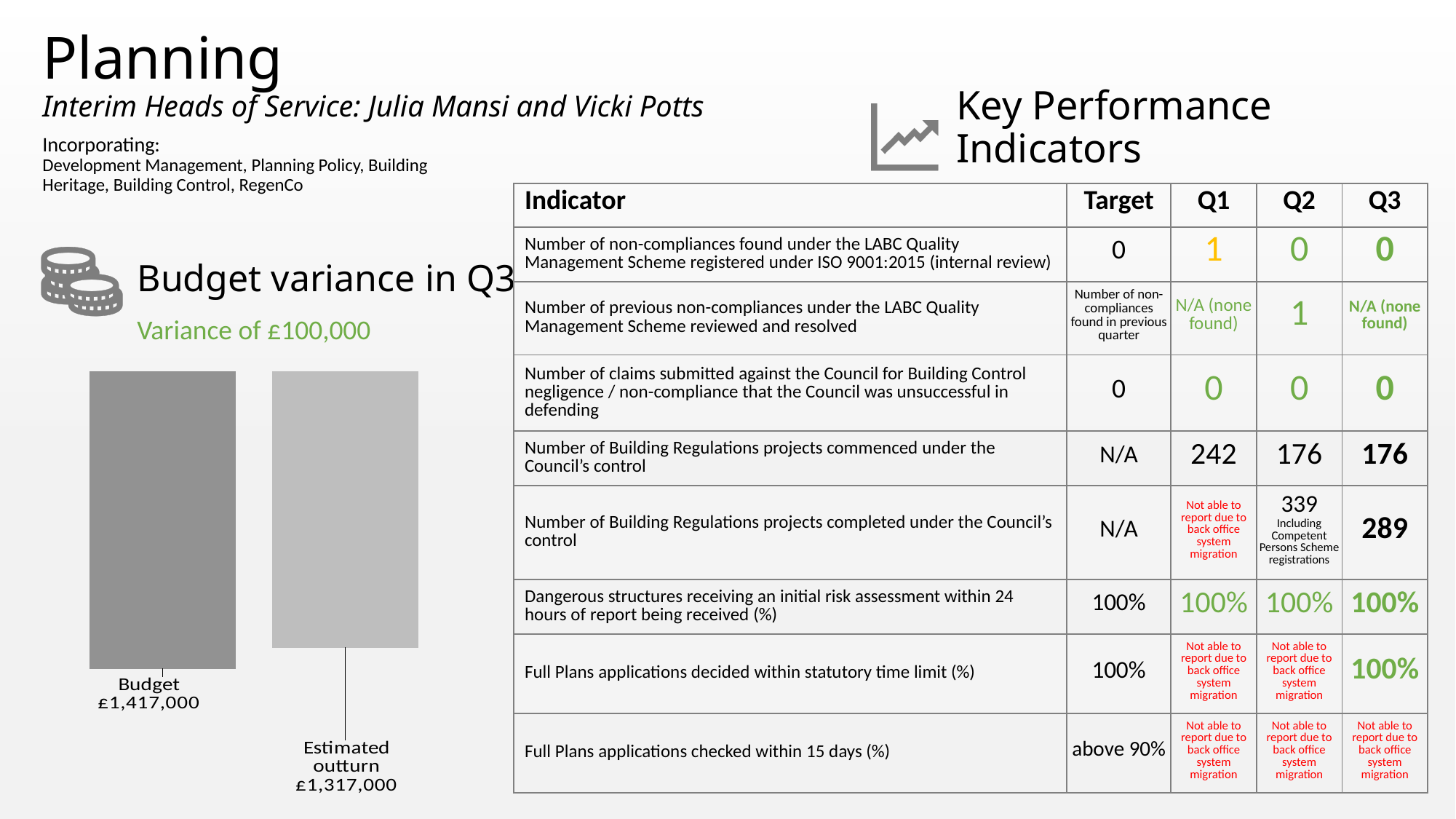
What is the difference between the Budget and Estimated outturn values in the budget variance chart? £100,000 What type of chart is shown under the 'Budget variance in Q3' heading? bar chart What is the heading above the bar chart on the left of the slide? Budget variance in Q3 What is the value of the Budget bar in the budget variance chart? £1,417,000 What is the value of the Estimated outturn bar in the budget variance chart? £1,317,000 Which category has the lowest value in the budget variance chart? Estimated outturn Do the values fall or rise from the Budget bar to the Estimated outturn bar in the budget variance chart? fall How many bars does the budget variance chart have? 2 Which bar is taller in the budget variance chart, Budget or Estimated outturn? Budget Which category has the highest value in the budget variance chart? Budget What variance amount is stated above the budget variance chart? Variance of £100,000